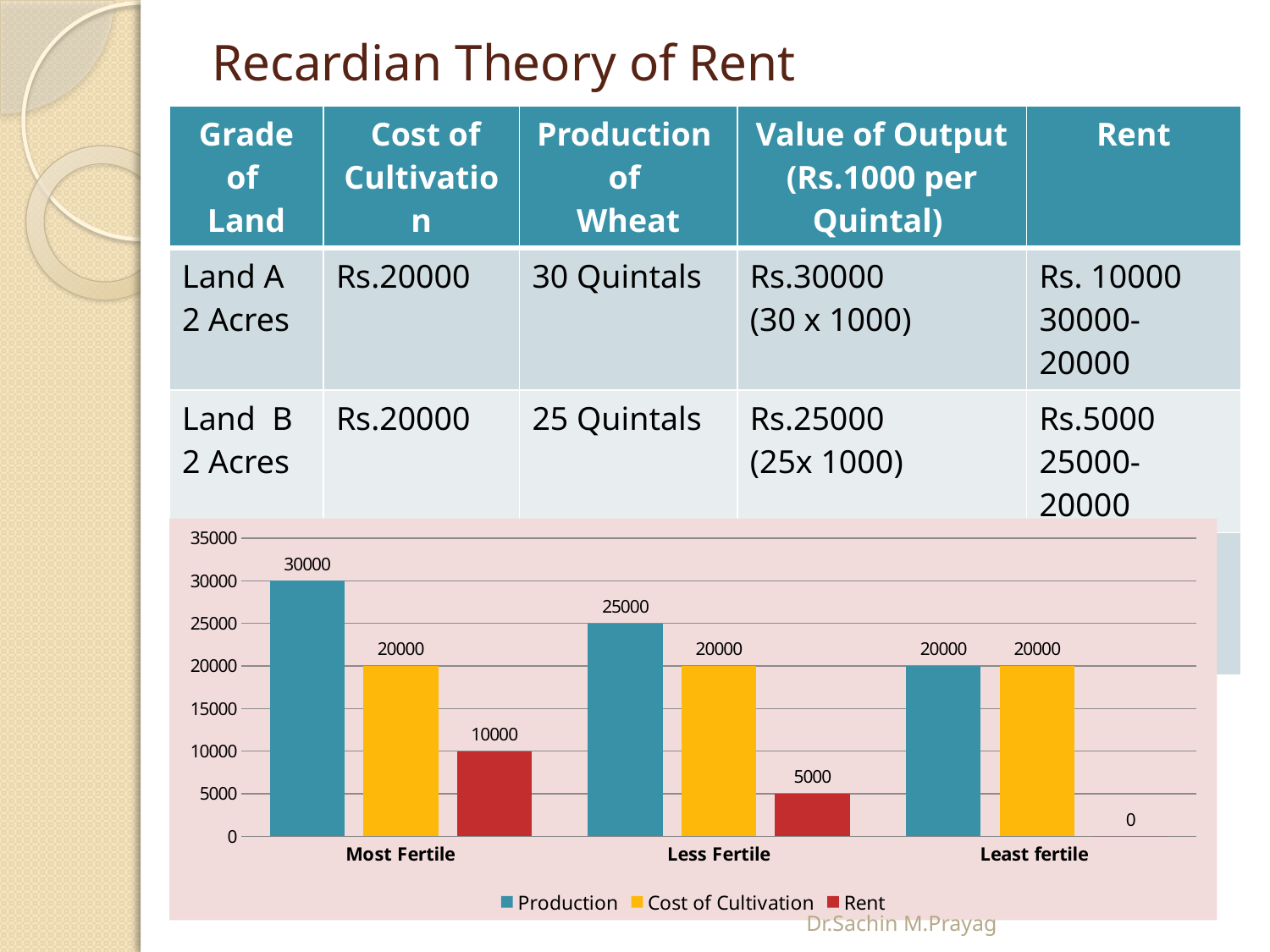
How many categories are shown on the x axis of the chart? 3 Which category has the lowest Rent value? Least fertile Does the Production value rise or fall from Most Fertile to Least fertile? Fall What is the Production value for Most Fertile land? 30000 What is the Rent value for Less Fertile land? 5000 What kind of chart is shown on the slide? Bar chart Which is larger, the Rent for Most Fertile land or the Rent for Less Fertile land? Most Fertile Which series is shown in red in the chart? Rent How many series does the chart legend list? 3 Which category has the highest Production value? Most Fertile What is the Cost of Cultivation value for Least fertile land? 20000 What is the difference between Production and Cost of Cultivation for Less Fertile land? 5000